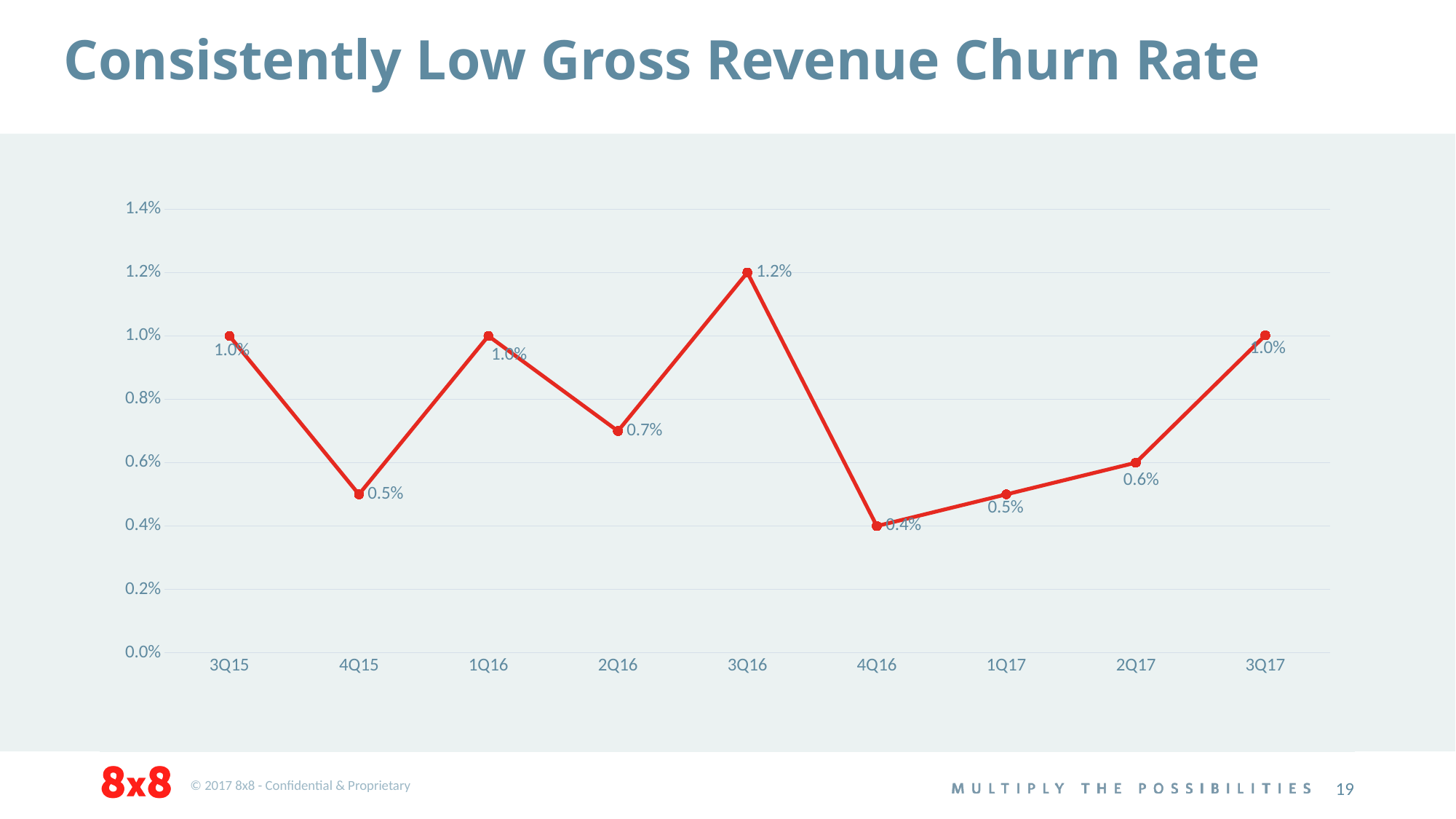
How many quarters are plotted on the chart? 9 Which quarter has the highest gross revenue churn rate? 3Q16 Which is larger, the churn rate in 4Q15 or the churn rate in 2Q16? 2Q16 What is the difference between the churn rate in 3Q16 and the churn rate in 4Q16? 0.8% Does the churn rate rise or fall from 4Q16 to 3Q17? rise What is the gross revenue churn rate for 3Q16? 1.2% What kind of chart is shown on the slide? line chart What is the gross revenue churn rate for 2Q17? 0.6% What is the gross revenue churn rate for 4Q16? 0.4% What is the gross revenue churn rate for 2Q16? 0.7% Is the churn rate for 1Q17 greater or less than 0.6%? less Which quarter has the lowest gross revenue churn rate? 4Q16